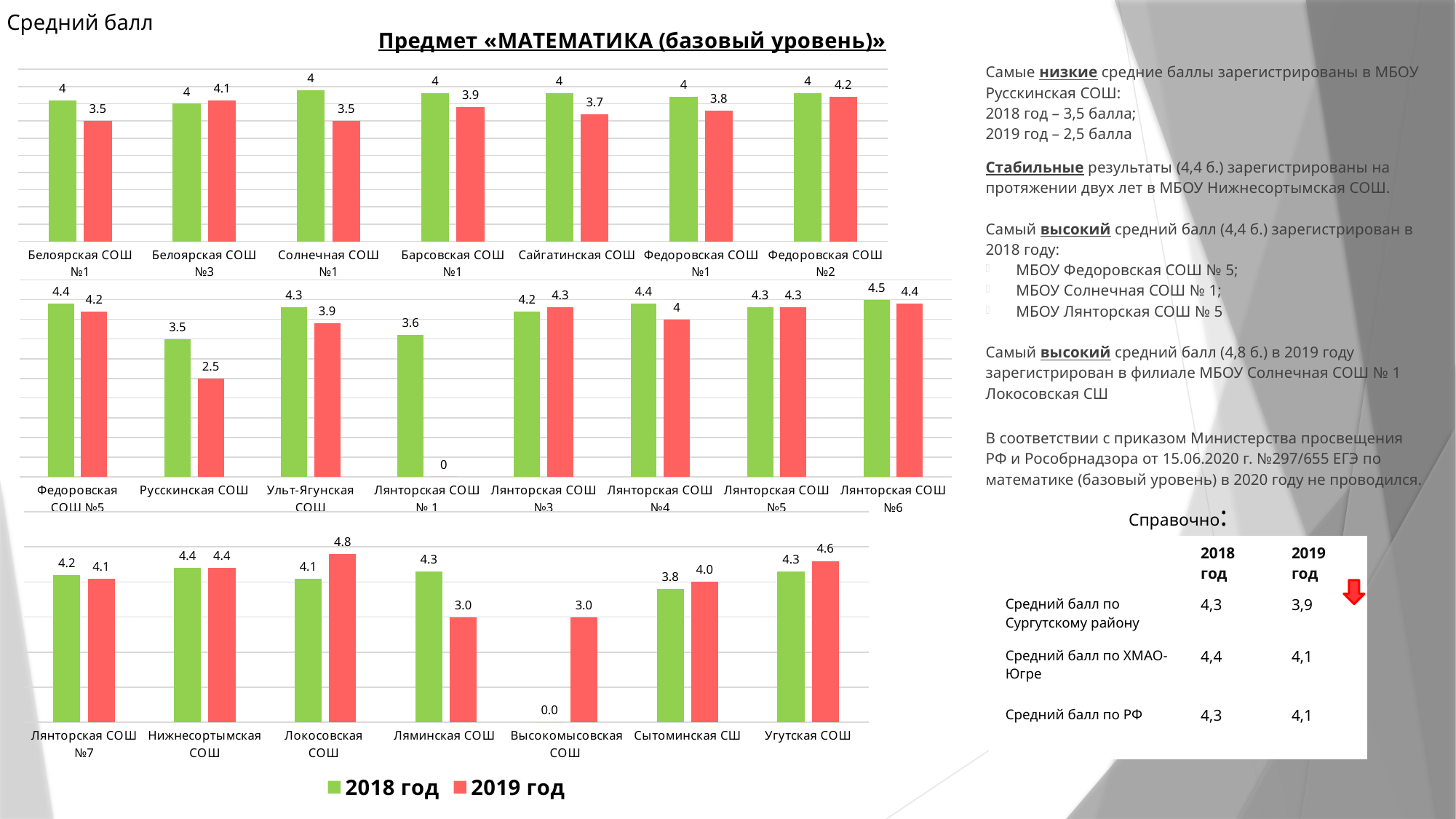
What type of chart is used on the slide? Bar chart How many series does the legend list? 2 In the middle chart, which school has the lowest 2019 год value? Лянторская СОШ № 1 In the bottom chart, which is larger for Ляминская СОШ: the 2018 год value or the 2019 год value? 2018 год In the bottom chart, what is the difference between the 2019 год and 2018 год values for Локосовская СОШ? 0.7 In the middle chart, which school has the highest 2018 год value? Лянторская СОШ №6 In the middle chart, what is the difference between the 2018 год and 2019 год values for Русскинская СОШ? 1 In the top chart, what is the 2019 год value for Федоровская СОШ №2? 4.2 In the bottom chart, which school has the highest 2019 год value? Локосовская СОШ How many schools are shown in the bottom chart? 7 In the middle chart, what is the 2019 год value for Русскинская СОШ? 2.5 In the top chart, what is the 2019 год value for Белоярская СОШ №1? 3.5